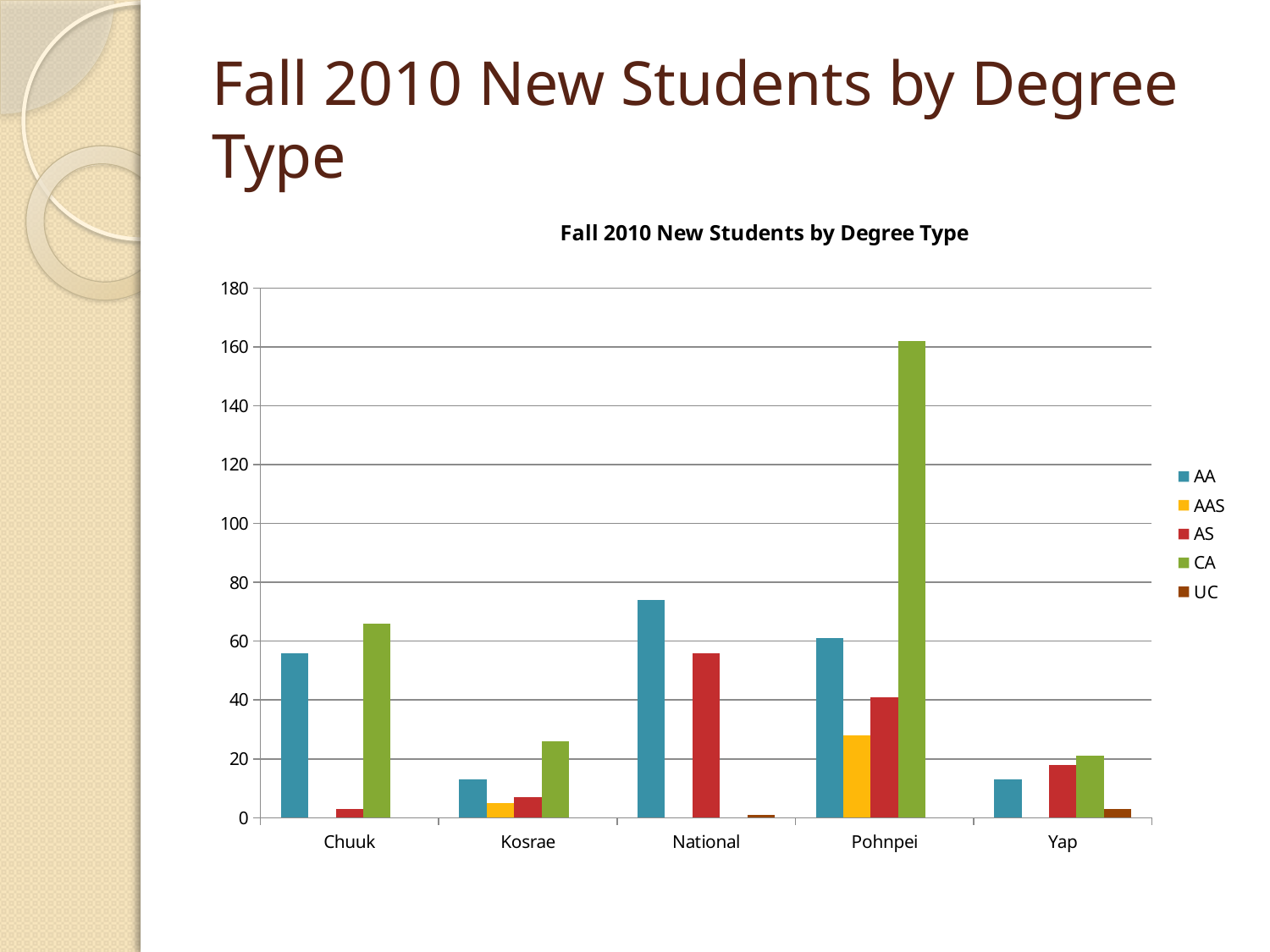
Which campus has the highest CA value? Pohnpei How many campuses are shown along the x axis? 5 Is the AA value for National greater or less than 60? greater How many series does the legend list? 5 What colour represents the CA series in the legend? green For Chuuk, which is larger: the AA value or the CA value? CA Is the CA value for Pohnpei greater or less than 140? greater Is the AA value for Chuuk greater or less than 60? less What kind of chart is shown on the slide? bar chart Which has the larger AA value: National or Pohnpei? National What is the title of the chart? Fall 2010 New Students by Degree Type Which campus has the highest AA value? National